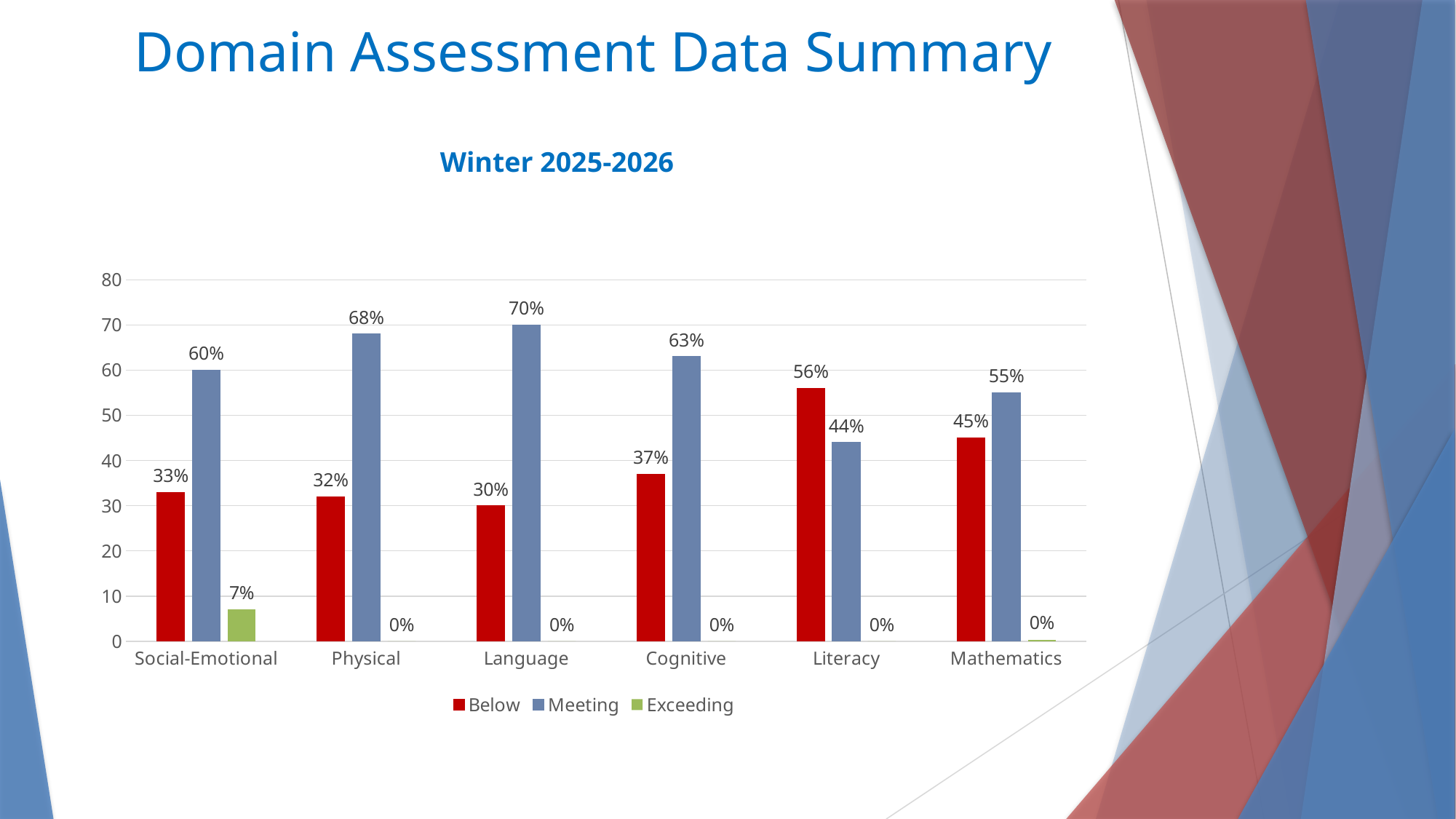
What is the Below value for Literacy? 56% What is the Meeting value for Language? 70% How many series does the legend list? 3 What is the Exceeding value for Social-Emotional? 7% What kind of chart is shown on the slide? Bar chart What is the difference between the Meeting and Below values for Cognitive? 26% Which category has the lowest Below value? Language How many categories are shown on the x axis? 6 What is the title of the chart? Winter 2025-2026 Which is larger for Literacy, the Below value or the Meeting value? Below Which category has the highest Meeting value? Language Which colour represents the Exceeding series in the legend? Green